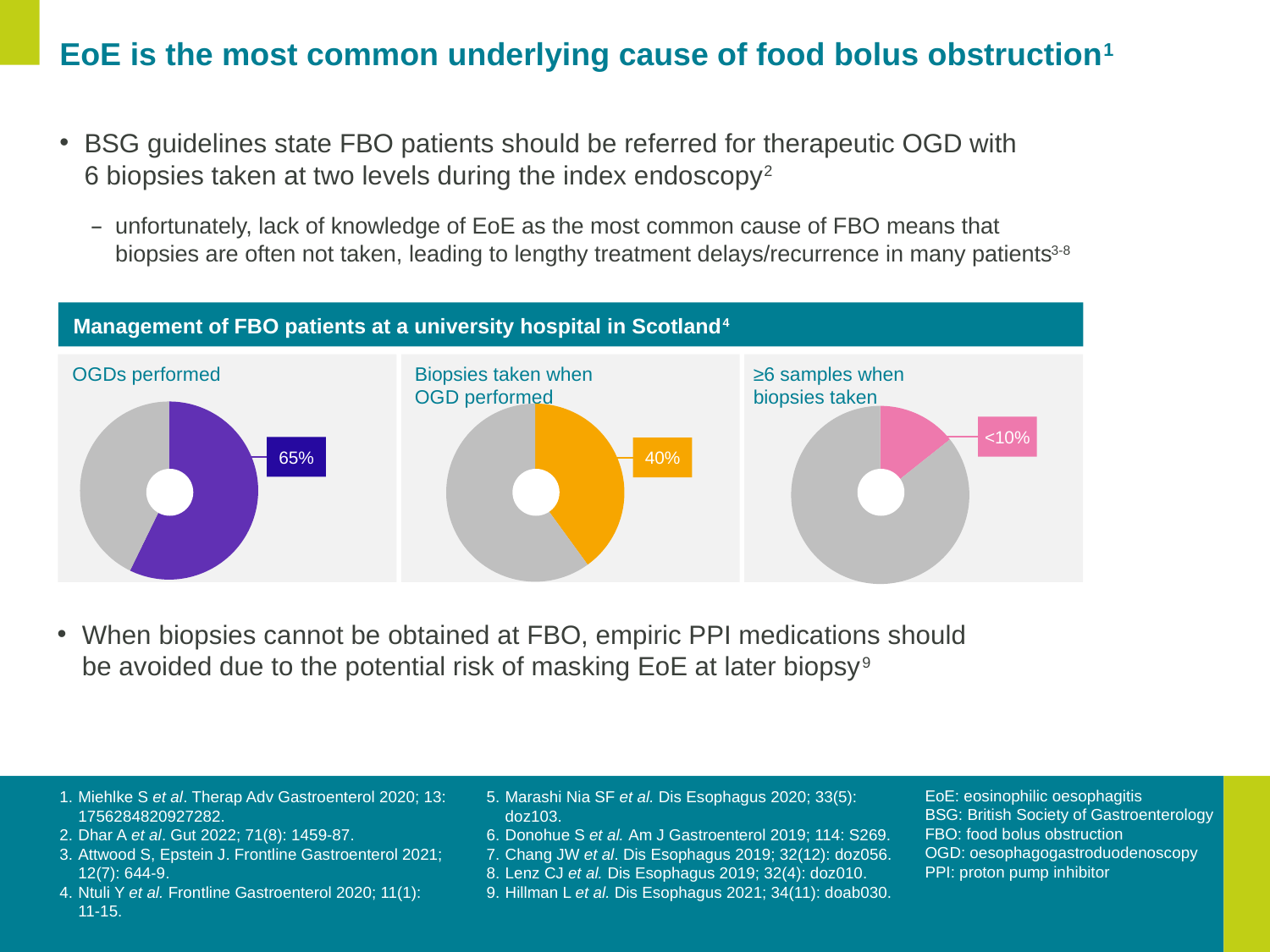
What kind of chart is used to show 'OGDs performed'? Pie chart What is the title of the panel containing the three pie charts? Management of FBO patients at a university hospital in Scotland In the 'Biopsies taken when OGD performed' chart, what percentage is shown for biopsies taken? 40% In the '≥6 samples when biopsies taken' chart, what value is labelled on the highlighted slice? <10% Of the three pie charts, which one shows the largest highlighted share? OGDs performed In the 'OGDs performed' chart, what percentage of FBO patients had an OGD performed? 65% How many pie charts are shown under the heading 'Management of FBO patients at a university hospital in Scotland'? 3 What is the difference between the 'OGDs performed' percentage and the 'Biopsies taken when OGD performed' percentage? 25% Is the highlighted share in the 'OGDs performed' chart greater or less than 50%? greater What colour is the highlighted slice in the 'Biopsies taken when OGD performed' chart? Orange Which is larger: the percentage in the 'OGDs performed' chart or the percentage in the 'Biopsies taken when OGD performed' chart? OGDs performed Of the three pie charts, which one shows the smallest highlighted share? ≥6 samples when biopsies taken